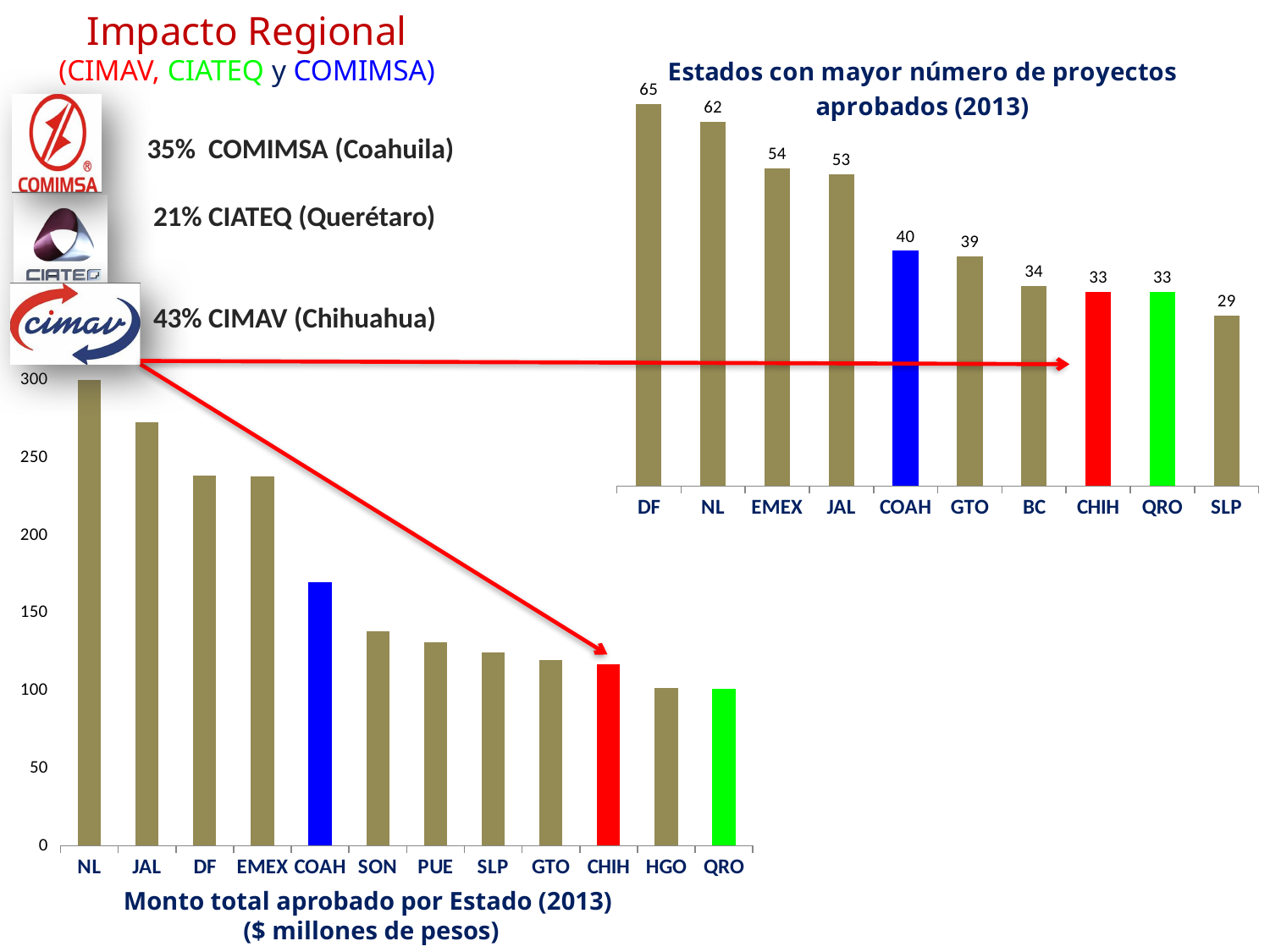
In the chart 'Estados con mayor número de proyectos aprobados (2013)', which state has the highest number of approved projects? DF How many states are shown in the chart 'Monto total aprobado por Estado (2013)'? 12 In the chart 'Monto total aprobado por Estado (2013)', is the value for SON greater or less than 150? less In the chart 'Estados con mayor número de proyectos aprobados (2013)', how many projects does DF have? 65 In the chart 'Estados con mayor número de proyectos aprobados (2013)', what is the value for COAH? 40 What type of chart is 'Monto total aprobado por Estado (2013)'? bar chart In the chart 'Monto total aprobado por Estado (2013)', is the value for JAL greater or less than 250? greater How many states are shown in the chart 'Estados con mayor número de proyectos aprobados (2013)'? 10 In the chart 'Estados con mayor número de proyectos aprobados (2013)', which state has the lowest number of approved projects? SLP In the chart 'Estados con mayor número de proyectos aprobados (2013)', what is the difference between the values for NL and EMEX? 8 In the chart 'Estados con mayor número de proyectos aprobados (2013)', which has a larger value, GTO or BC? GTO In the chart 'Monto total aprobado por Estado (2013)', do the values rise or fall from left to right along the x axis? fall